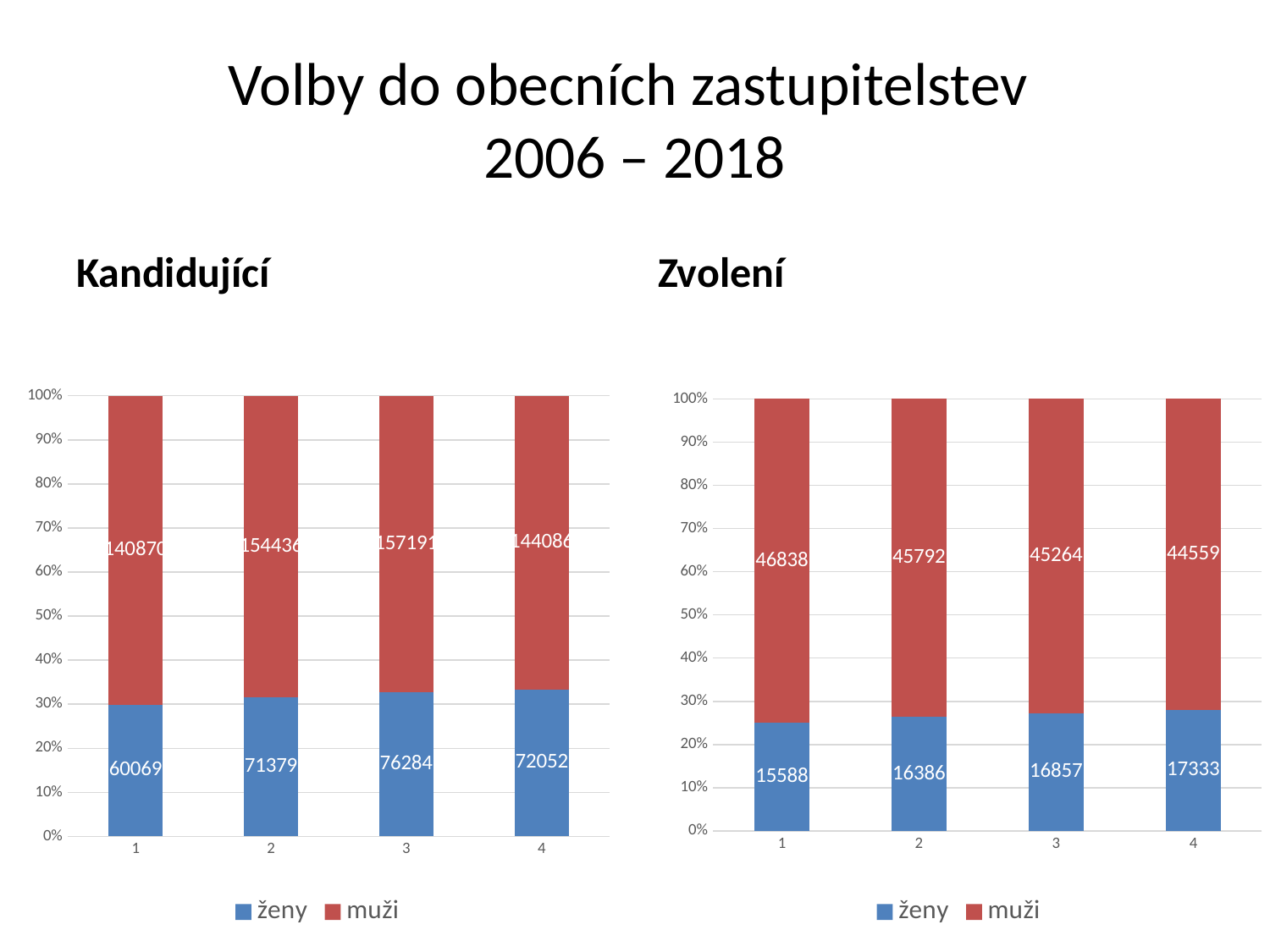
In the Zvolení chart, which category has the highest value for ženy? 4 In the Kandidující chart, what is the value for ženy in category 3? 76284 In the Zvolení chart, which category has the lowest value for muži? 4 In the Zvolení chart, what is the value for muži in category 2? 45792 In the Kandidující chart, which is larger: the ženy value for category 2 or for category 4? category 4 In the Kandidující chart, what is the value for muži in category 1? 140870 In the Zvolení chart, do the ženy values rise or fall from category 1 to category 4? rise What kind of chart is the Zvolení chart? stacked bar chart In the Kandidující chart, which category has the highest value for muži? 3 How many series does the legend of the Kandidující chart list? 2 In the Zvolení chart, what is the difference between the ženy values for category 4 and category 1? 1745 In the Zvolení chart, what is the total of the stacked bar for category 1? 62426